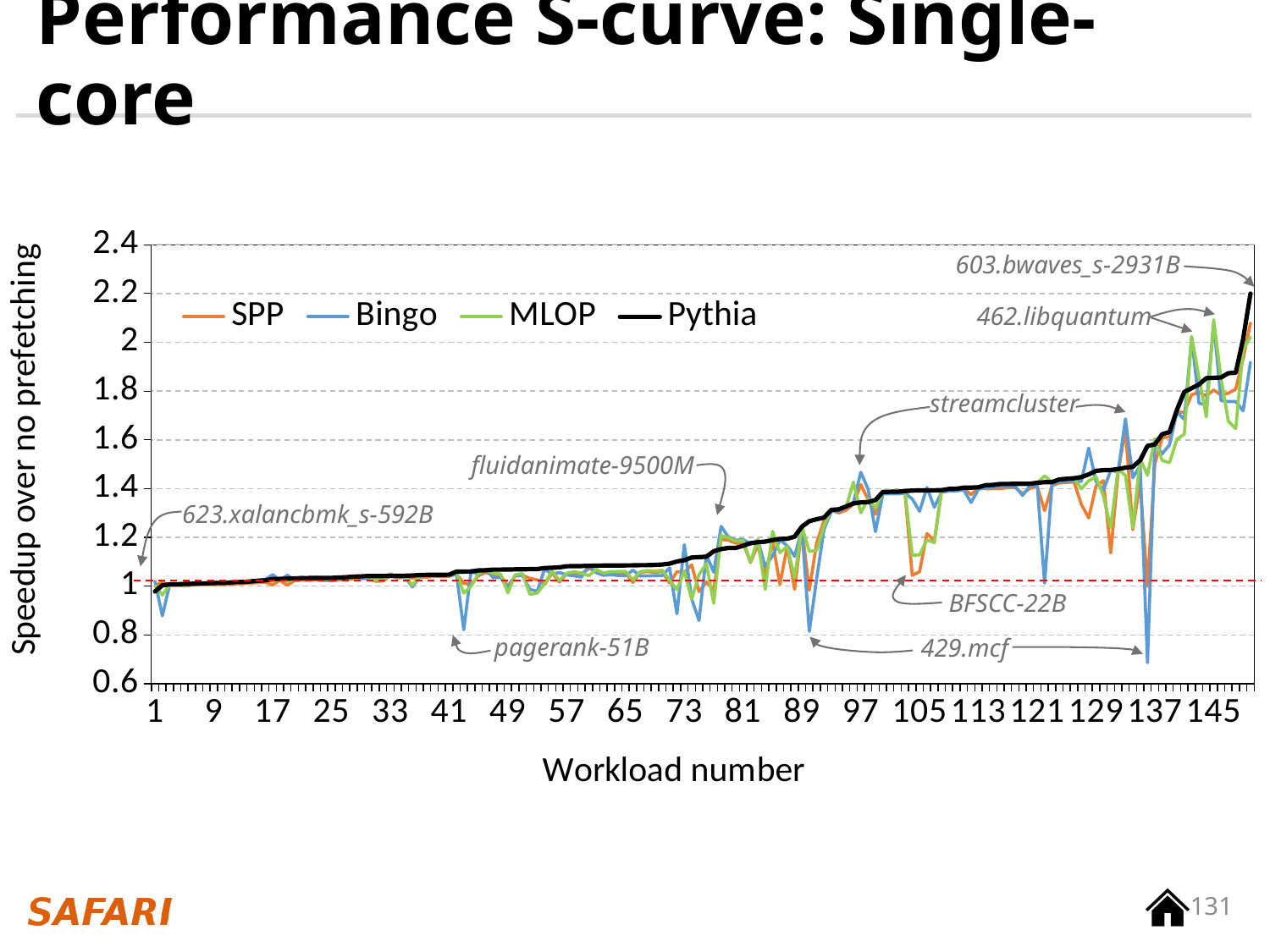
At the 429.mcf dip near workload 137, which is larger, the Bingo value or the Pythia value? Pythia What is the title of the y axis? Speedup over no prefetching At the last workload on the right, which series reaches the highest speedup? Pythia Which series are listed in the legend? SPP, Bingo, MLOP, Pythia Is the Pythia value for 603.bwaves_s-2931B greater or less than 2? greater Is the Pythia value at workload 145 greater or less than 1.6? greater Does the Pythia line rise or fall as the workload number increases along the x axis? rise Is the Pythia value at workload 97 greater or less than 1.2? greater What kind of chart is shown on the slide? line chart How many series does the legend list? 4